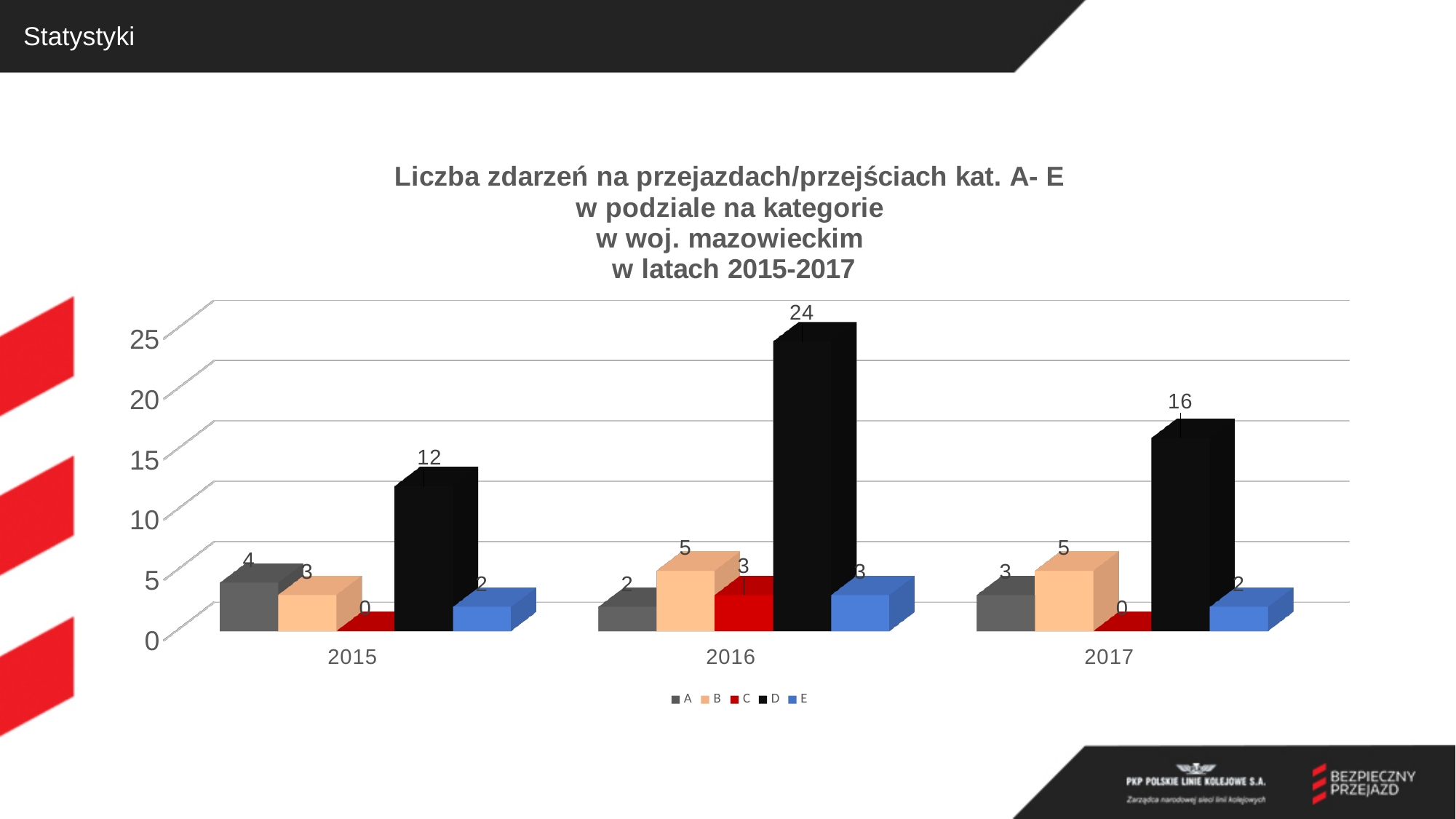
Which is larger, the value for series A in 2015 or the value for series A in 2016? 2015 What is the value for series D in 2016? 24 What is the value for series B in 2017? 5 In which year is the value for series D highest? 2016 What kind of chart is shown on the slide? bar chart What is the value for series C in 2015? 0 Is the value for series D in 2017 greater or less than 20? less In which year is the value for series D lowest? 2015 How many series does the legend list? 5 What is the difference between the value for series D in 2016 and in 2017? 8 How many years are shown on the x axis? 3 What is the value for series A in 2015? 4